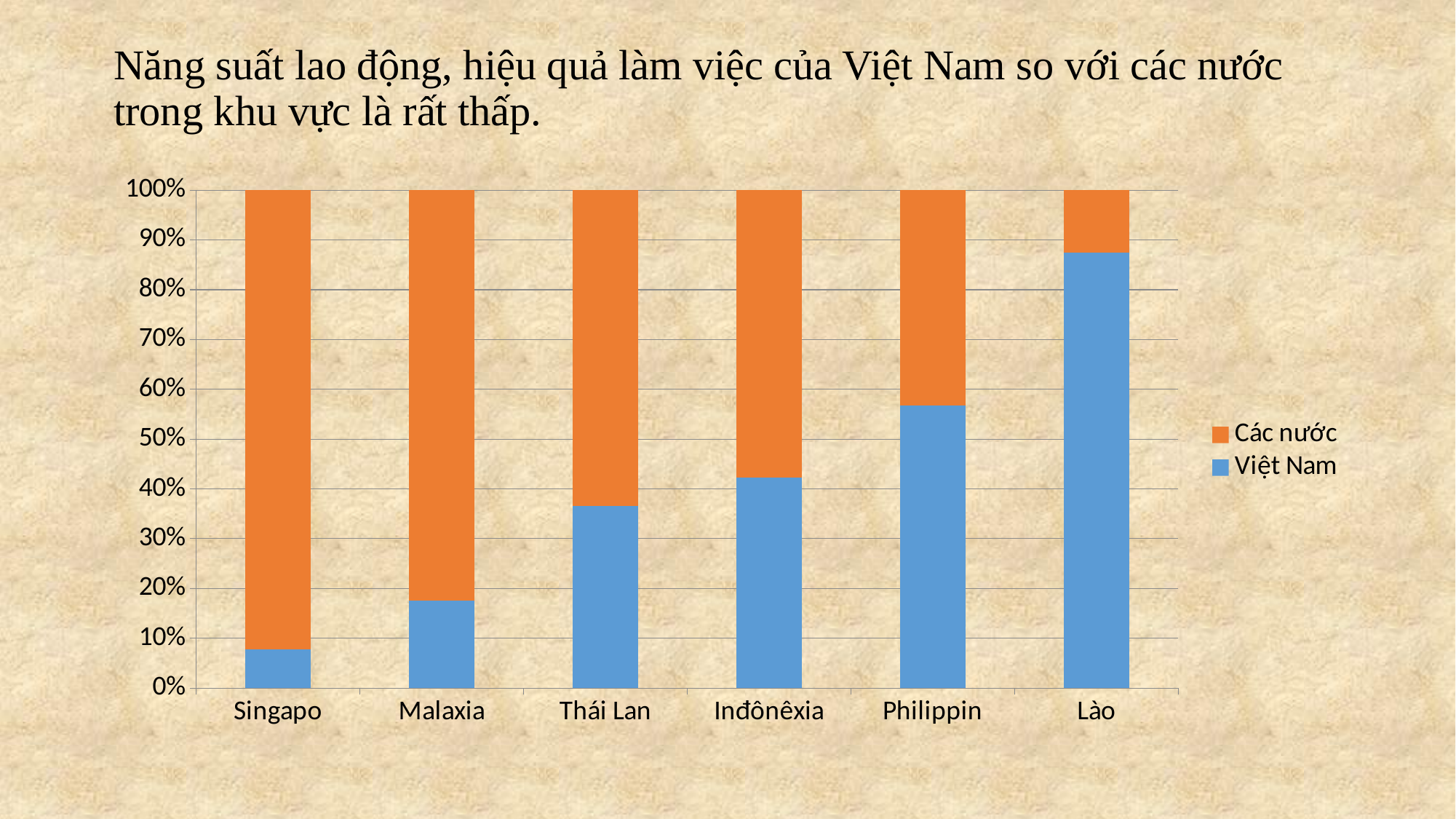
What kind of chart is shown on the slide? bar chart What are the two legend entries in the chart? Các nước and Việt Nam Which country has the highest Việt Nam share in the chart? Lào Is the Việt Nam value for Singapo greater or less than 10%? less How many series does the chart legend list? 2 Is the Việt Nam value for Inđônêxia greater or less than 40%? greater How many countries are shown on the x axis of the chart? 6 Which has a larger Việt Nam share, Philippin or Thái Lan? Philippin Does the Việt Nam share rise or fall from Singapo to Lào along the x axis? rise Is the Việt Nam value for Malaxia greater or less than 20%? less Which country has the lowest Việt Nam share in the chart? Singapo